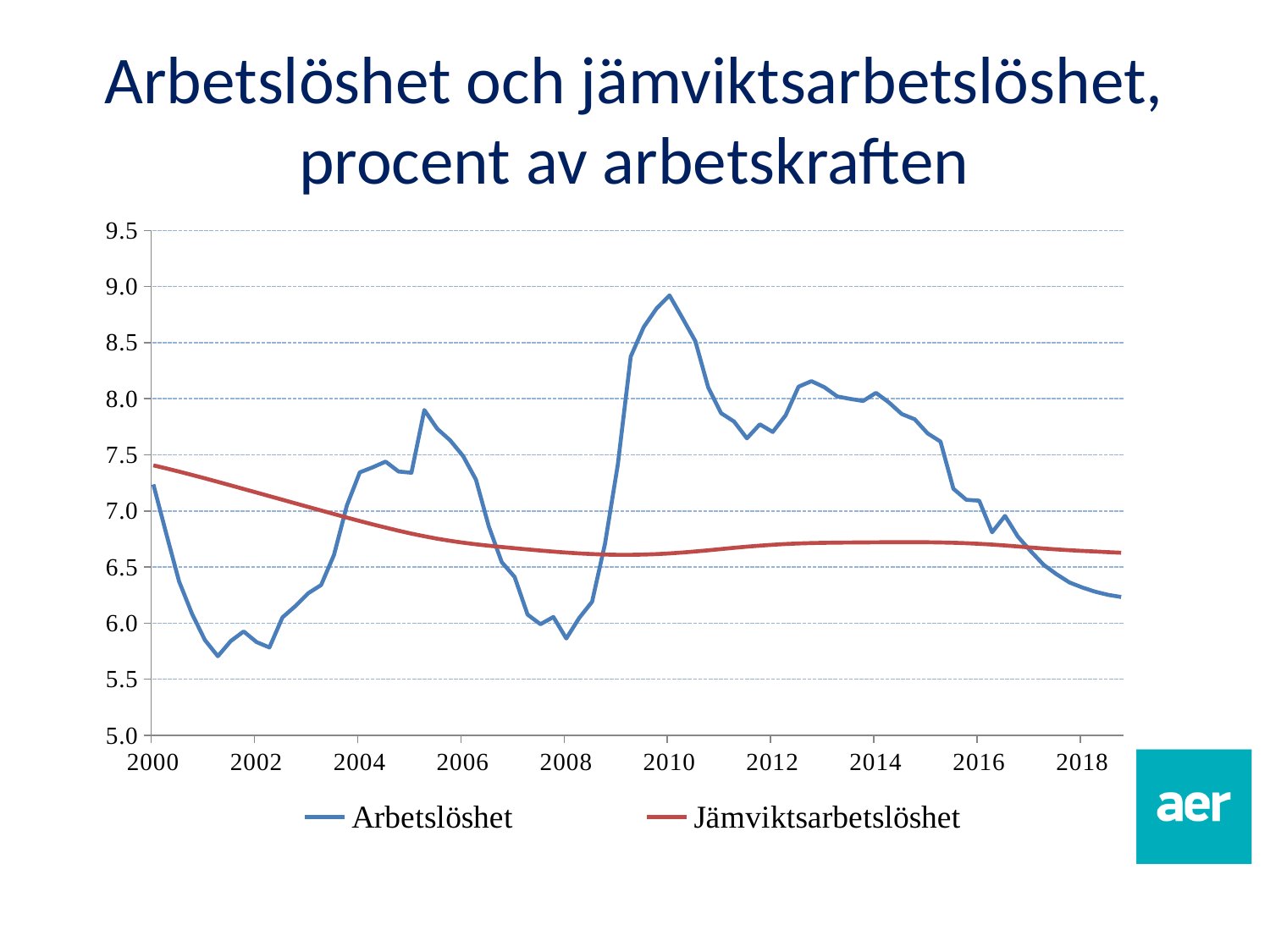
In 2010, which series has the higher value, Arbetslöshet or Jämviktsarbetslöshet? Arbetslöshet Is the value for Jämviktsarbetslöshet in 2018 greater or less than 7.0? less Which colour is the Jämviktsarbetslöshet line? Red Is the value for Jämviktsarbetslöshet in 2000 greater or less than 7.0? greater Is the value for Arbetslöshet in 2010 greater or less than 8.5? greater Around which year does the Arbetslöshet line reach its highest point? 2010 What kind of chart is shown on the slide? Line chart In 2002, which series has the higher value, Arbetslöshet or Jämviktsarbetslöshet? Jämviktsarbetslöshet How many series does the legend list? 2 What are the two series named in the legend? Arbetslöshet and Jämviktsarbetslöshet Does the Jämviktsarbetslöshet line rise or fall between 2000 and 2008? Fall